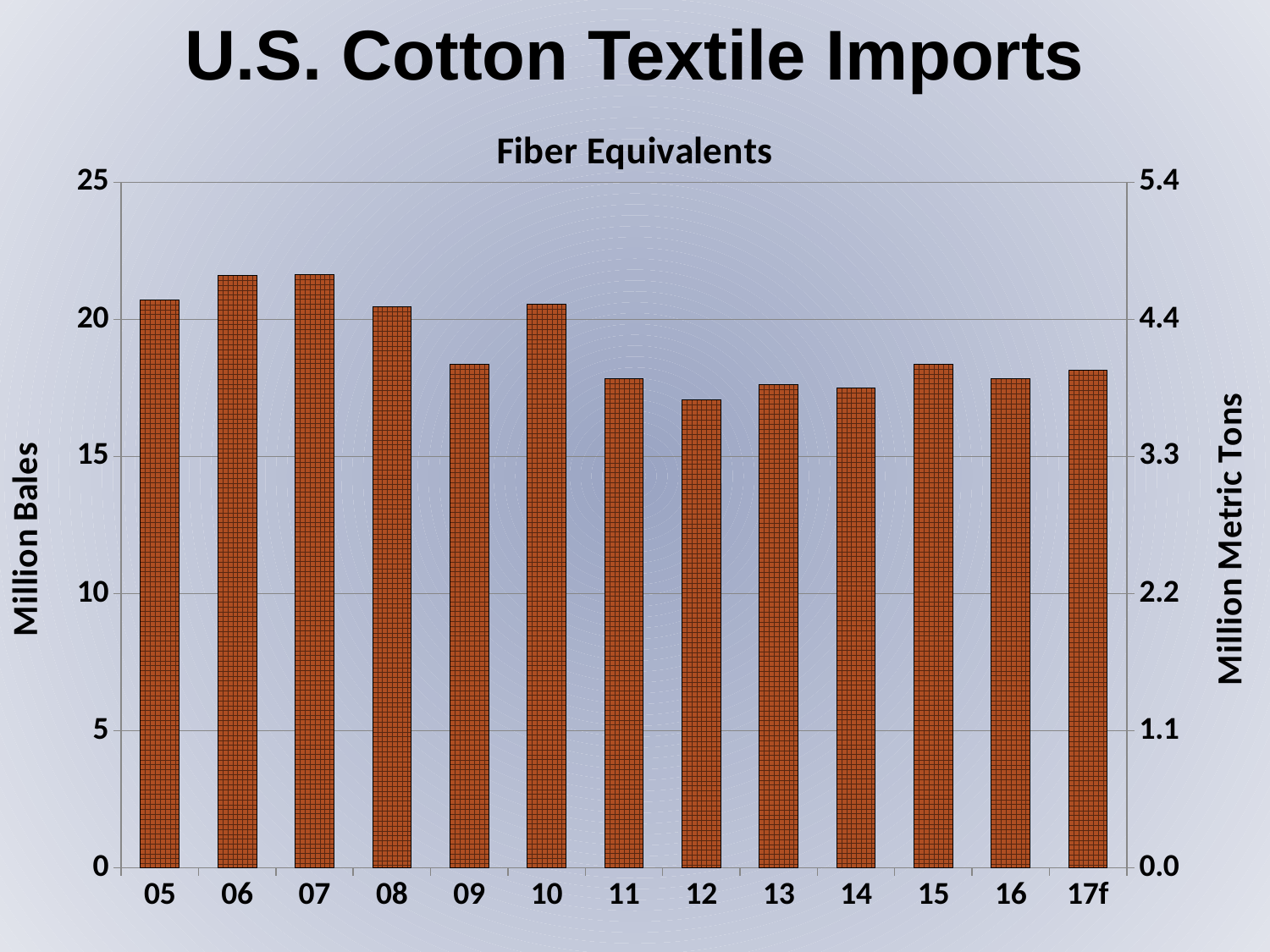
Is the value for 09 greater or less than 20 million bales? less Which is larger, the value for 10 or the value for 12? 10 Which is larger, the value for 05 or the value for 09? 05 How many years (categories) are plotted on the x axis? 13 Is the value for 05 greater or less than 20 million bales? greater Which year has the lowest cotton textile imports? 12 Is the value for 12 greater or less than 20 million bales? less What is the label of the right vertical axis? Million Metric Tons What kind of chart is shown on the slide? bar chart What is the label of the left vertical axis? Million Bales Overall, do the values rise or fall from 05 to 17f? fall